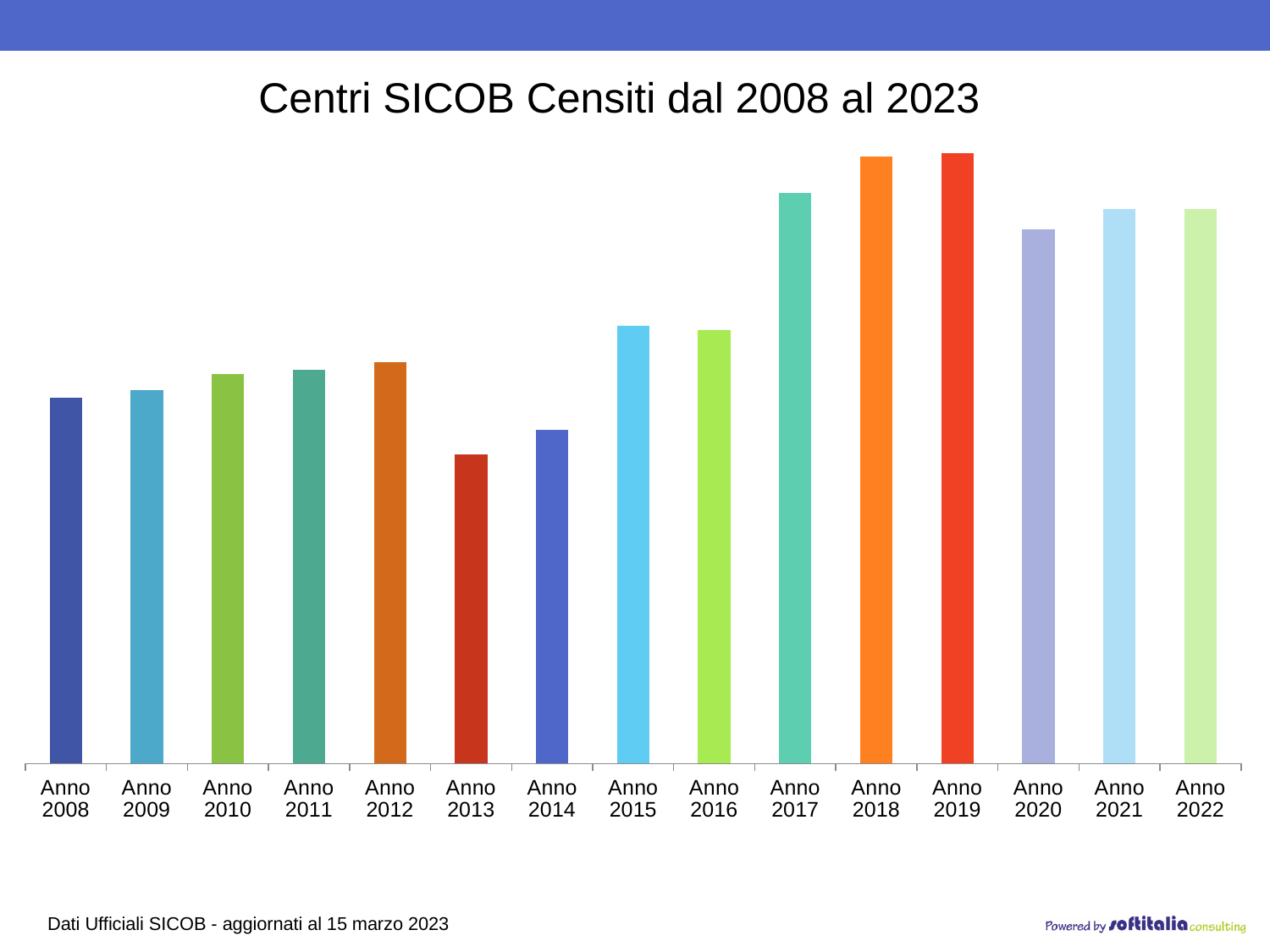
Which bar is taller, Anno 2013 or Anno 2014? Anno 2014 Which bar is taller, Anno 2017 or Anno 2020? Anno 2017 What source note is printed at the bottom left of the slide? Dati Ufficiali SICOB - aggiornati al 15 marzo 2023 Which bar is taller, Anno 2014 or Anno 2015? Anno 2015 Do the bars rise or fall from Anno 2012 to Anno 2013? fall Do the bars rise or fall from Anno 2008 to Anno 2012? rise Do the bars rise or fall from Anno 2016 to Anno 2019? rise What is the title of the chart? Centri SICOB Censiti dal 2008 al 2023 What kind of chart is shown on the slide? bar chart How many years (categories) are plotted on the x axis? 15 Which year has the lowest bar? Anno 2013